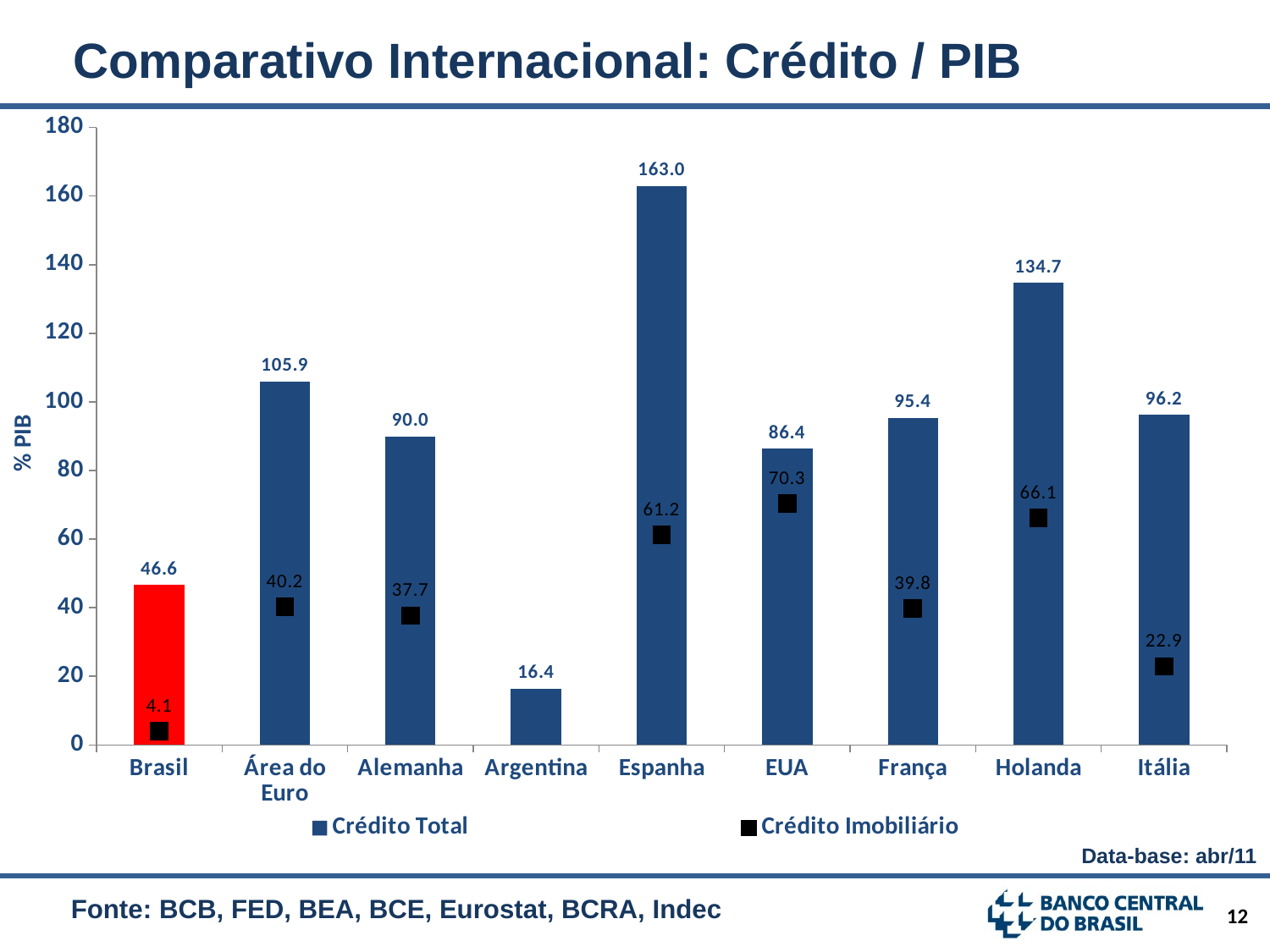
Which country has the highest Crédito Total? Espanha Which has a larger Crédito Total, França or Itália? Itália What is the Crédito Imobiliário value for Holanda? 66.1 What is the Crédito Imobiliário value for EUA? 70.3 What type of chart is shown on the slide? Bar chart How many categories are shown on the x axis? 9 What is the Crédito Total value for Espanha? 163.0 What is the difference between the Crédito Total values of Holanda and Alemanha? 44.7 Which category has the lowest Crédito Imobiliário value? Brasil Which country has the lowest Crédito Total? Argentina How many series does the legend list? 2 What is the Crédito Total value for Brasil? 46.6